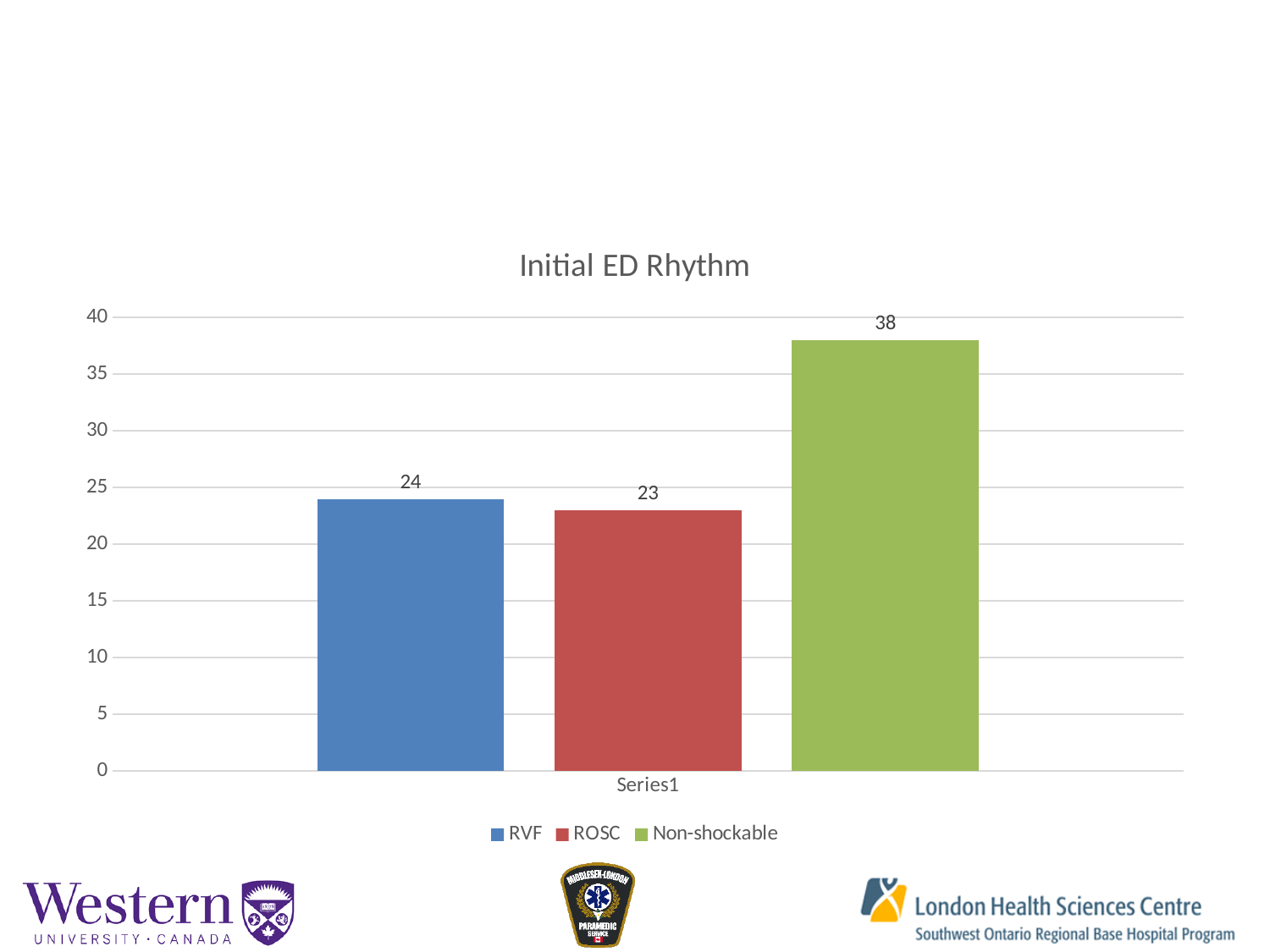
What kind of chart is shown? bar chart What is the value for RVF? 24 What is the difference between the RVF value and the ROSC value? 1 Which series has the highest value? Non-shockable Is the value for Non-shockable greater or less than 35? greater What is the title of the chart? Initial ED Rhythm What is the value for ROSC? 23 What is the value for Non-shockable? 38 How many series does the legend list? 3 What is the difference between the Non-shockable value and the RVF value? 14 Which is larger, the value for Non-shockable or the value for ROSC? Non-shockable Which series has the lowest value? ROSC